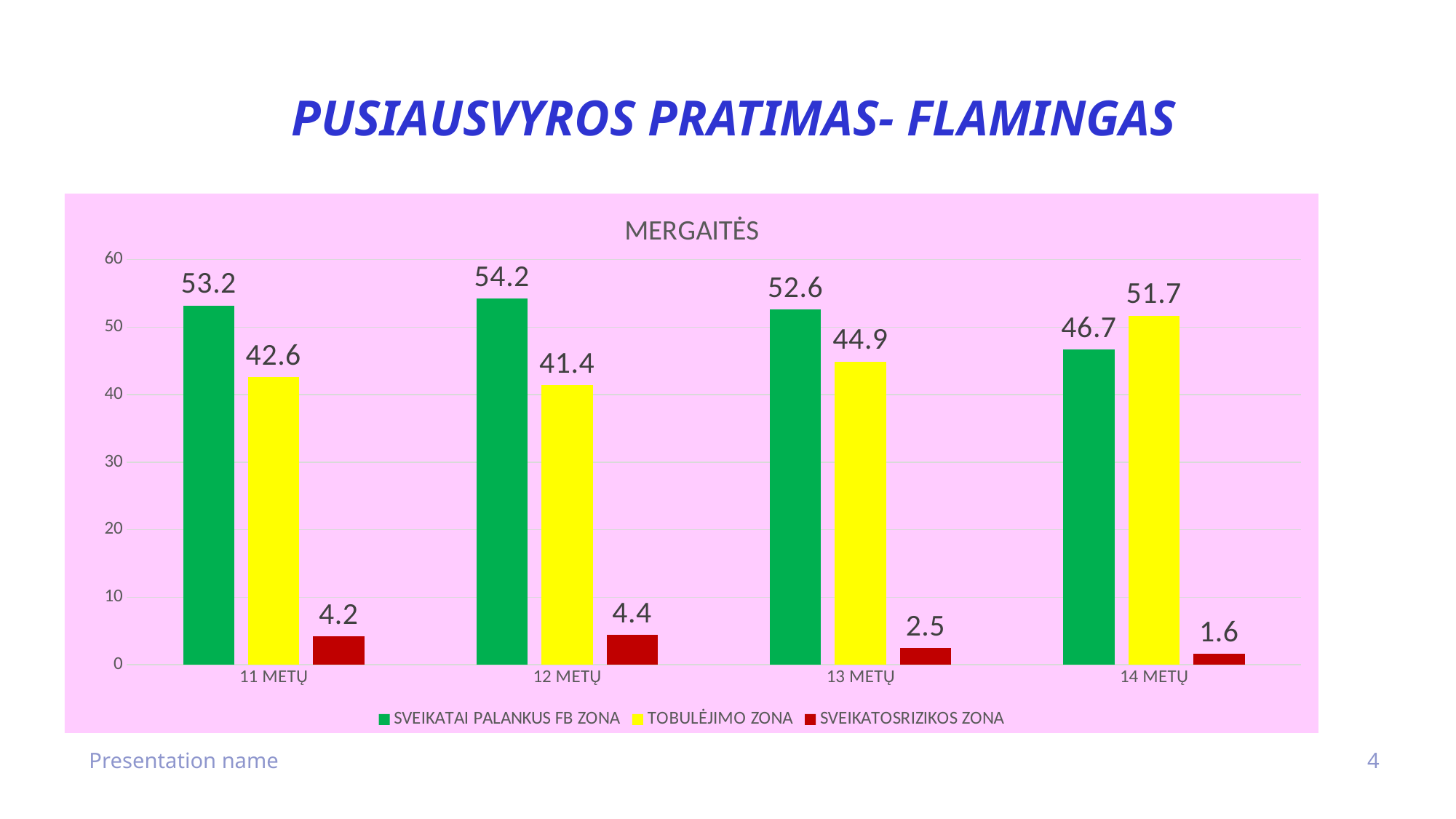
What is the title of the chart? MERGAITĖS How many age groups are shown on the x axis? 4 What is the value for TOBULĖJIMO ZONA at 14 METŲ? 51.7 Which age group has the highest value for SVEIKATAI PALANKUS FB ZONA? 12 METŲ Which age group has the lowest value for SVEIKATOSRIZIKOS ZONA? 14 METŲ Which is larger at 14 METŲ: SVEIKATAI PALANKUS FB ZONA or TOBULĖJIMO ZONA? TOBULĖJIMO ZONA How many series does the legend list? 3 Is the value for TOBULĖJIMO ZONA at 12 METŲ greater or less than 50? less What is the value for SVEIKATOSRIZIKOS ZONA at 13 METŲ? 2.5 What is the value for SVEIKATAI PALANKUS FB ZONA at 12 METŲ? 54.2 What kind of chart is shown on the slide? bar chart What is the difference between the SVEIKATAI PALANKUS FB ZONA and TOBULĖJIMO ZONA values at 11 METŲ? 10.6